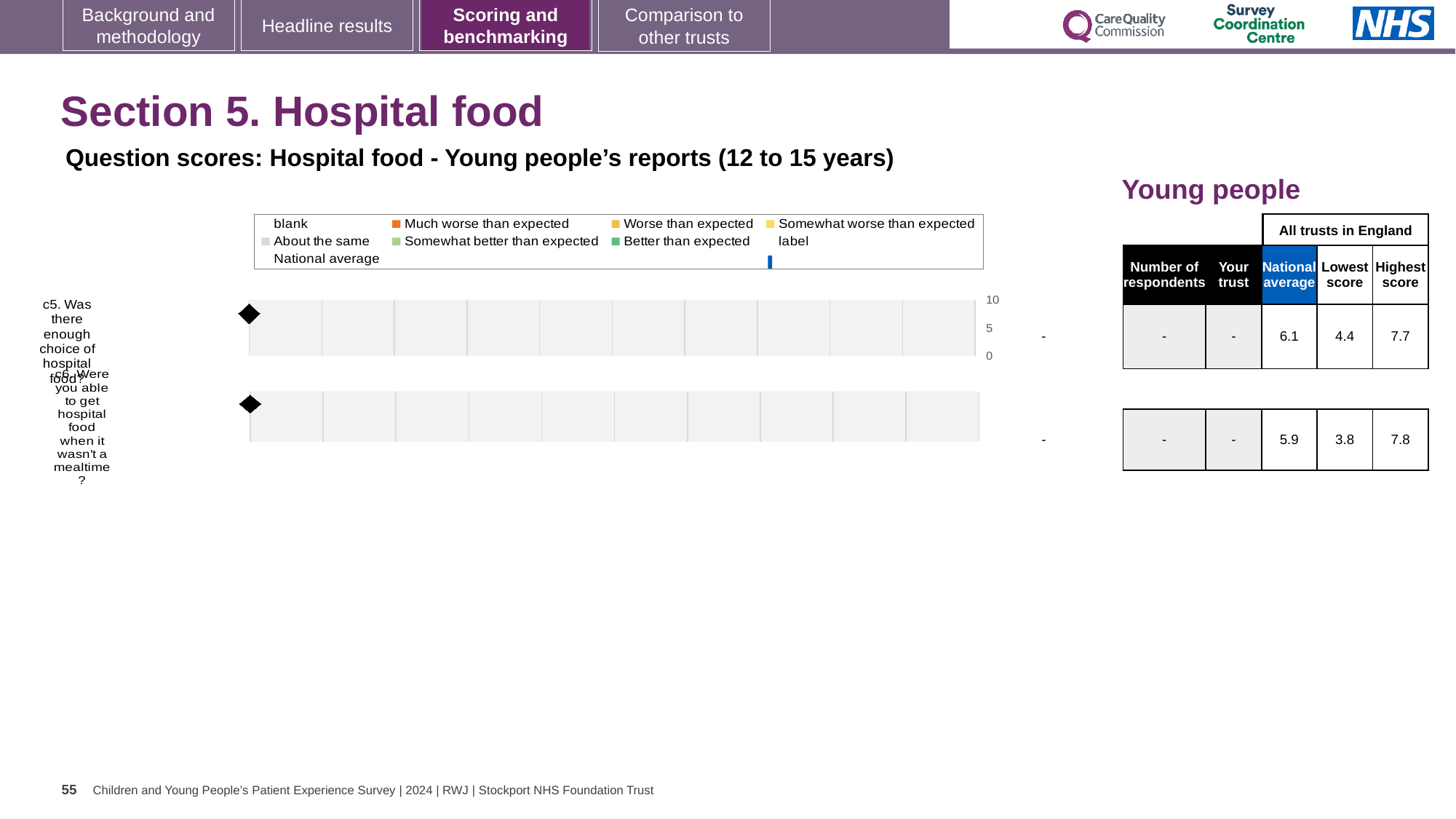
In the table next to the chart, what is the national average score for c6 (Were you able to get hospital food when it wasn't a mealtime?)? 5.9 What kind of chart is used to show the question scores for hospital food? bar chart What is the difference between the highest and lowest scores across all trusts in England for c5? 3.3 Is the national average score for c6 greater or less than 5? greater In the table next to the chart, what is the highest score across all trusts in England for c6? 7.8 How many questions (categories) are shown on the chart? 2 Which question has the higher national average score, c5 or c6? c5 Which question is listed first on the chart? c5. Was there enough choice of hospital food? In the table next to the chart, what is the national average score for c5 (Was there enough choice of hospital food?)? 6.1 What is the highest value shown on the chart's axis? 10 What is shown as the trust's own score for c5 in the table? - In the table next to the chart, what is the lowest score across all trusts in England for c5? 4.4